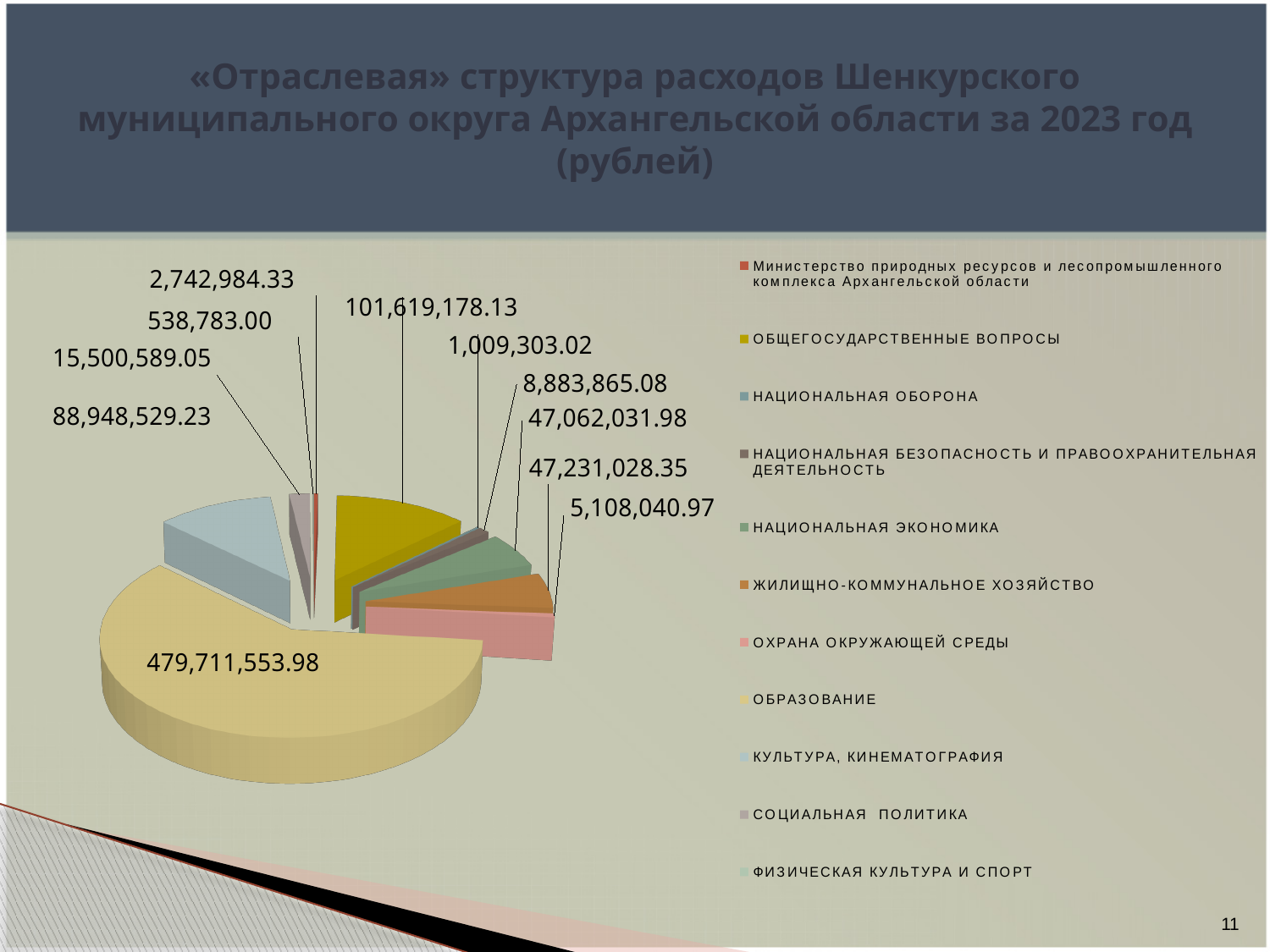
How many categories does the legend of the pie chart list? 11 What is the value for ОБЩЕГОСУДАРСТВЕННЫЕ ВОПРОСЫ? 101,619,178.13 What is the value for КУЛЬТУРА, КИНЕМАТОГРАФИЯ? 88,948,529.23 What is the difference between the values 47,231,028.35 and 47,062,031.98 shown on the pie chart? 168,996.37 What kind of chart is shown on the slide? Pie chart What year does the chart title say the expenditure structure refers to? 2023 Which is larger: the value for ОБЩЕГОСУДАРСТВЕННЫЕ ВОПРОСЫ or the value for КУЛЬТУРА, КИНЕМАТОГРАФИЯ? ОБЩЕГОСУДАРСТВЕННЫЕ ВОПРОСЫ What is the smallest value printed on the pie chart? 538,783.00 Which category has the largest slice in the pie chart? ОБРАЗОВАНИЕ What is the value of the largest slice in the pie chart? 479,711,553.98 What is the difference between the value for ОБРАЗОВАНИЕ (479,711,553.98) and the value for ОБЩЕГОСУДАРСТВЕННЫЕ ВОПРОСЫ (101,619,178.13)? 378,092,375.85 What unit does the chart title say the values are in? рублей